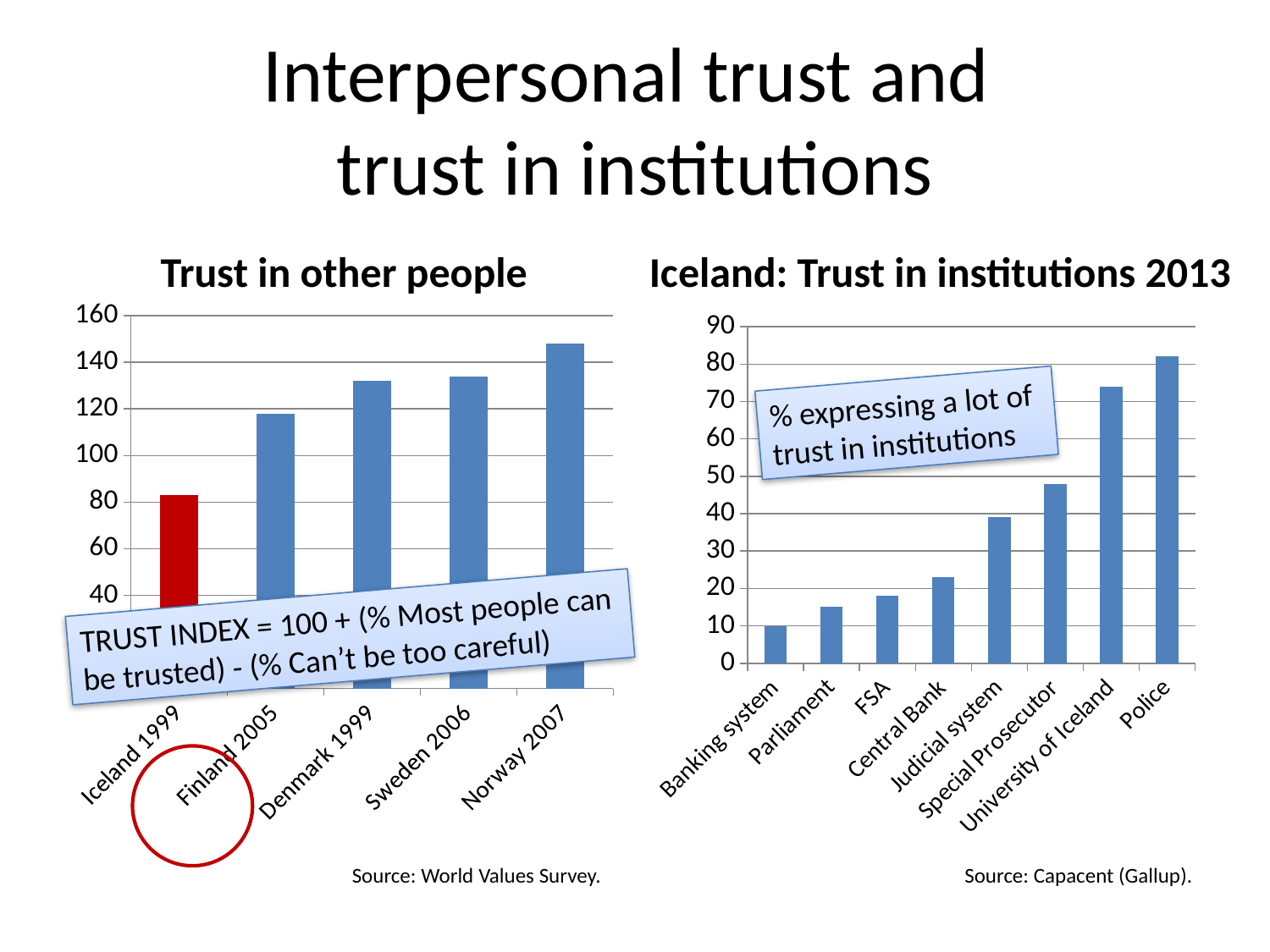
In the "Trust in other people" chart, which category has the highest value? Norway 2007 In the "Iceland: Trust in institutions 2013" chart, is the value for University of Iceland greater or less than 70? greater In the "Iceland: Trust in institutions 2013" chart, which institution has the lowest value? Banking system In the "Iceland: Trust in institutions 2013" chart, which institution has the highest value? Police In the "Iceland: Trust in institutions 2013" chart, do the values rise or fall from left to right? rise In the "Trust in other people" chart, is the value for Iceland 1999 greater or less than 100? less How many institutions are shown in the "Iceland: Trust in institutions 2013" chart? 8 What kind of chart is the "Trust in other people" chart? bar chart In the "Trust in other people" chart, which category has the lowest value? Iceland 1999 In the "Trust in other people" chart, is the value for Norway 2007 greater or less than 140? greater In the "Trust in other people" chart, which bar is shown in red? Iceland 1999 How many countries are shown in the "Trust in other people" chart? 5